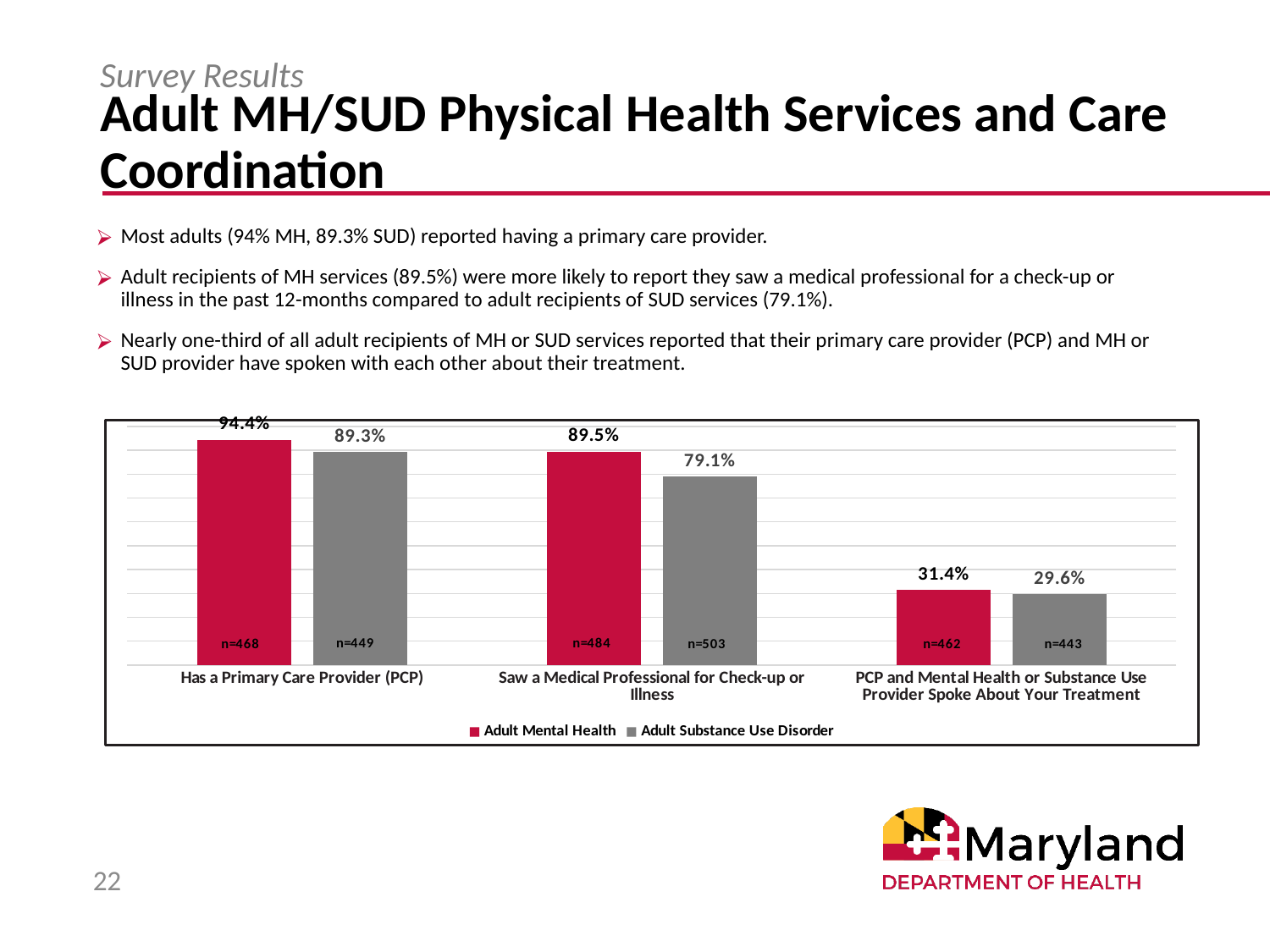
How many series does the chart legend list? 2 How many categories are shown on the x axis of the chart? 3 What is the Adult Substance Use Disorder value for 'Saw a Medical Professional for Check-up or Illness'? 79.1% What is the difference between the Adult Mental Health and Adult Substance Use Disorder values for 'Saw a Medical Professional for Check-up or Illness'? 10.4% Which category has the highest Adult Substance Use Disorder value? Has a Primary Care Provider (PCP) What colour are the Adult Mental Health bars in the chart? Red What is the Adult Mental Health value for 'Has a Primary Care Provider (PCP)'? 94.4% What is the Adult Substance Use Disorder value for 'PCP and Mental Health or Substance Use Provider Spoke About Your Treatment'? 29.6% What is the sample size (n) shown on the Adult Mental Health bar for 'Saw a Medical Professional for Check-up or Illness'? n=484 Which category has the lowest Adult Mental Health value? PCP and Mental Health or Substance Use Provider Spoke About Your Treatment What type of chart is shown on the slide? Bar chart Which is larger for 'Has a Primary Care Provider (PCP)': the Adult Mental Health value or the Adult Substance Use Disorder value? Adult Mental Health